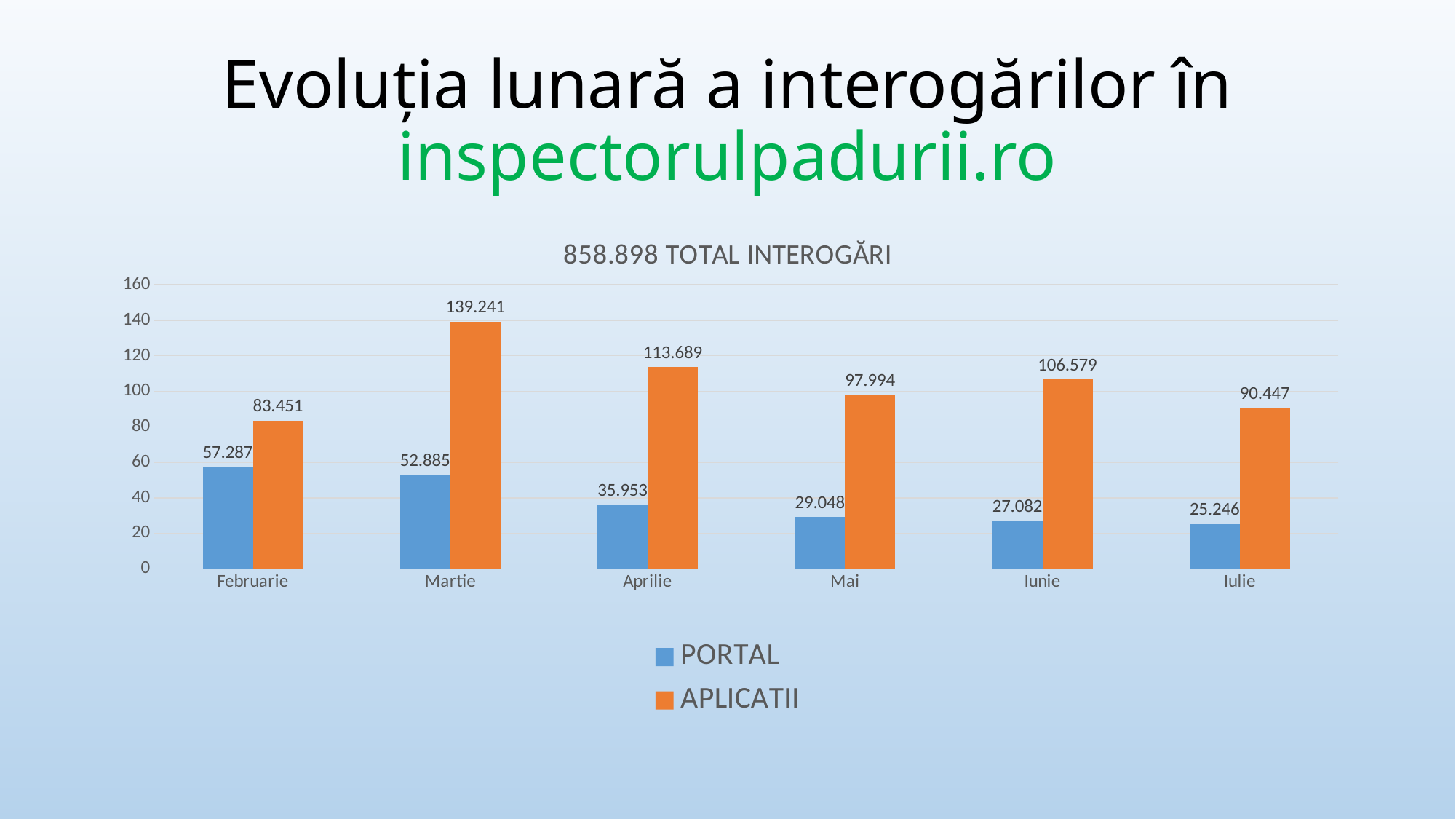
Which month has the highest APLICATII value? Martie What is the APLICATII value for Iunie? 106.579 How many months are shown on the x axis? 6 What is the title of the chart? 858.898 TOTAL INTEROGĂRI What kind of chart is shown on the slide? bar chart What is the difference between the APLICATII and PORTAL values for Martie? 86.356 Which is larger for Mai, the PORTAL value or the APLICATII value? APLICATII Is the APLICATII value for Aprilie greater or less than 100 on the axis? greater What is the PORTAL value for Iulie? 25.246 How many series does the legend list? 2 What is the PORTAL value for Martie? 52.885 Which month has the lowest PORTAL value? Iulie